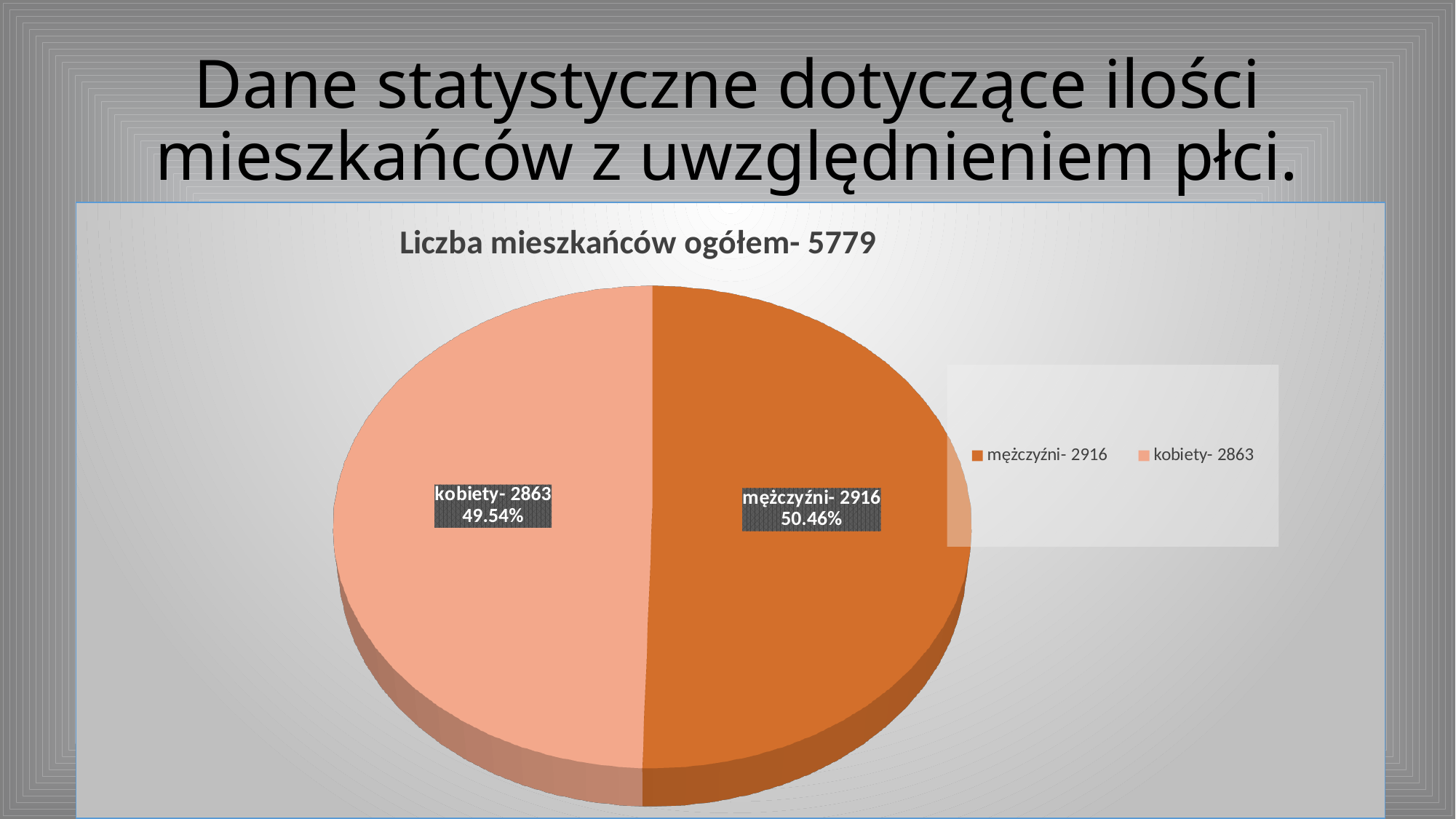
Which category has the smallest value? kobiety What kind of chart is shown on the slide? pie chart Which category has the larger value, mężczyźni or kobiety? mężczyźni What is the total number of residents shown in the chart title? 5779 How many slices does the pie chart have? 2 What is the value for kobiety? 2863 What is the difference between the values for mężczyźni and kobiety? 53 What share of the pie does the kobiety slice represent? 49.54% What is the value for mężczyźni? 2916 How many entries does the legend list? 2 What share of the pie does the mężczyźni slice represent? 50.46% What is the title of the chart? Liczba mieszkańców ogółem- 5779